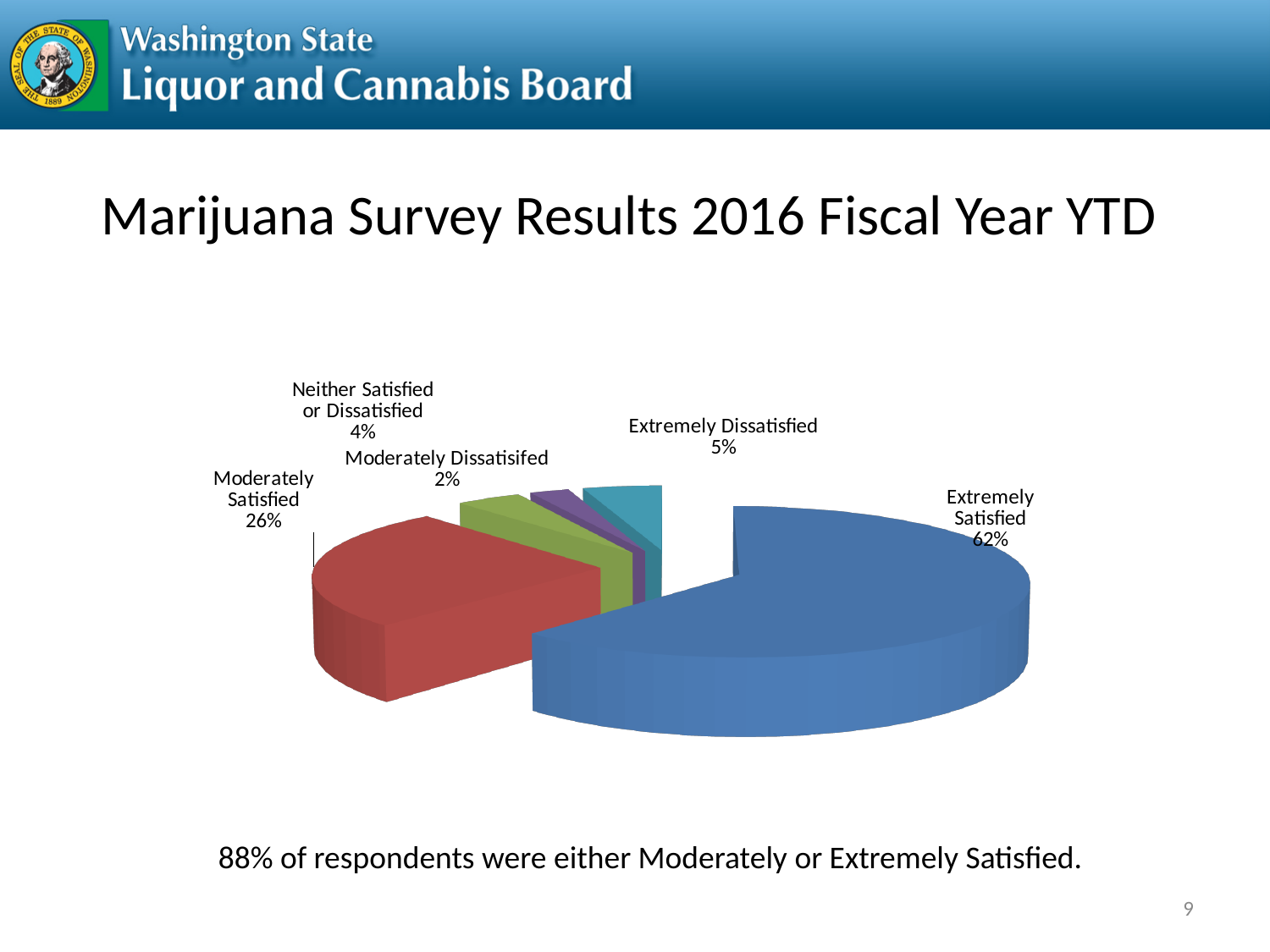
What percentage of respondents were Moderately Satisfied? 26% What percentage of respondents were Moderately Dissatisfied? 2% What percentage of respondents were Extremely Dissatisfied? 5% What kind of chart is shown on the slide? Pie chart Which category has the smallest share of the pie? Moderately Dissatisfied Which category has the largest share of the pie? Extremely Satisfied What percentage of respondents were Extremely Satisfied? 62% What percentage of respondents were Neither Satisfied or Dissatisfied? 4% How many categories are shown in the pie chart? 5 What is the title of the slide containing the chart? Marijuana Survey Results 2016 Fiscal Year YTD What is the difference in percentage points between Extremely Satisfied and Moderately Satisfied? 36 Which is larger, the share for Extremely Dissatisfied or the share for Neither Satisfied or Dissatisfied? Extremely Dissatisfied